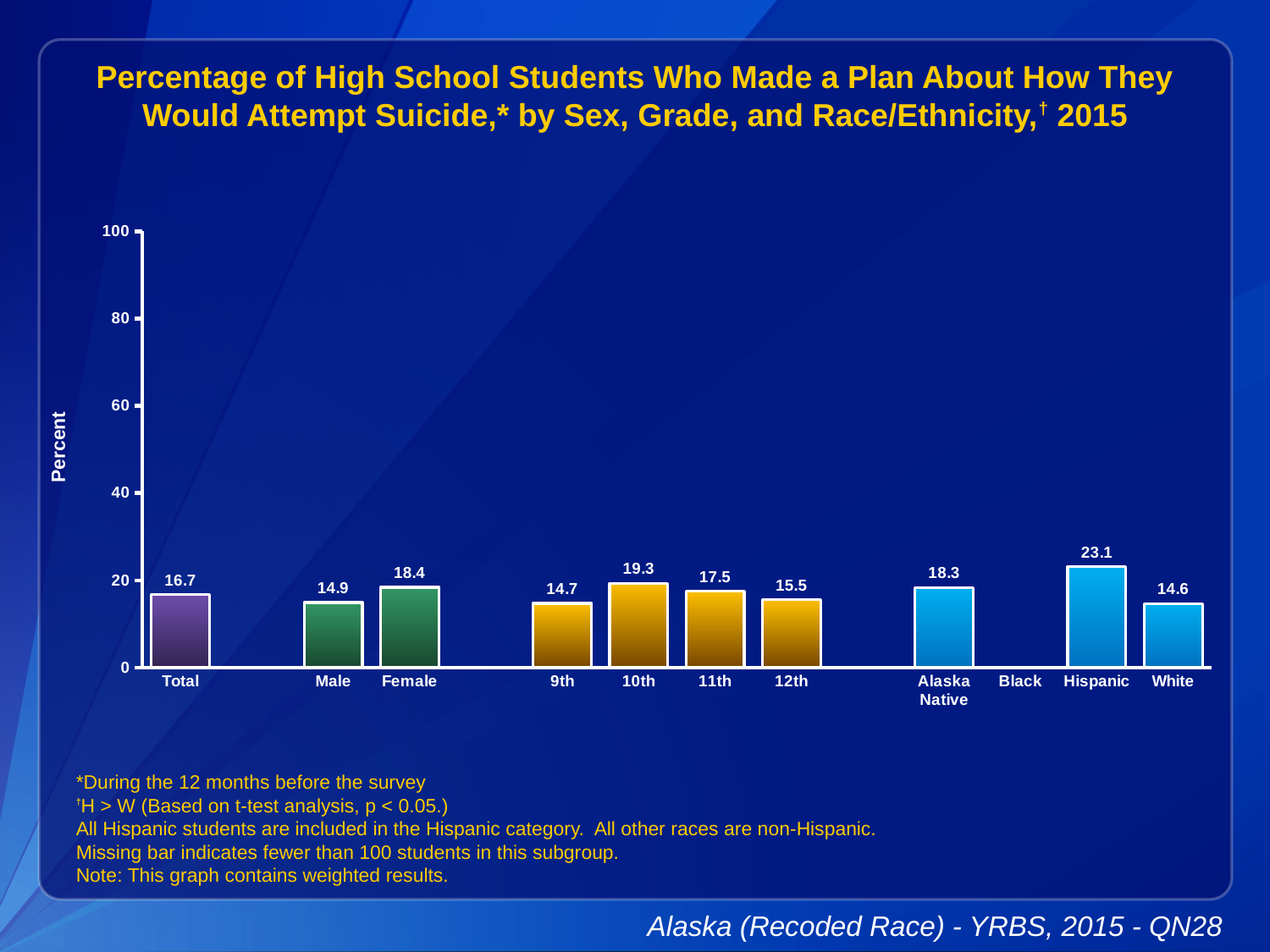
What is the value for 10th grade? 19.3 What is the value for Hispanic? 23.1 Which category has the highest value? Hispanic Which category has the lowest plotted value? White Which is larger, the value for 9th grade or the value for 12th grade? 12th How many categories have a bar plotted? 10 Which category on the x axis has no bar? Black What is the difference between the Female and Male values? 3.5 What kind of chart is shown? bar chart Is the value for Alaska Native greater or less than 20? less What is the value for Total? 16.7 What is the value for Female? 18.4